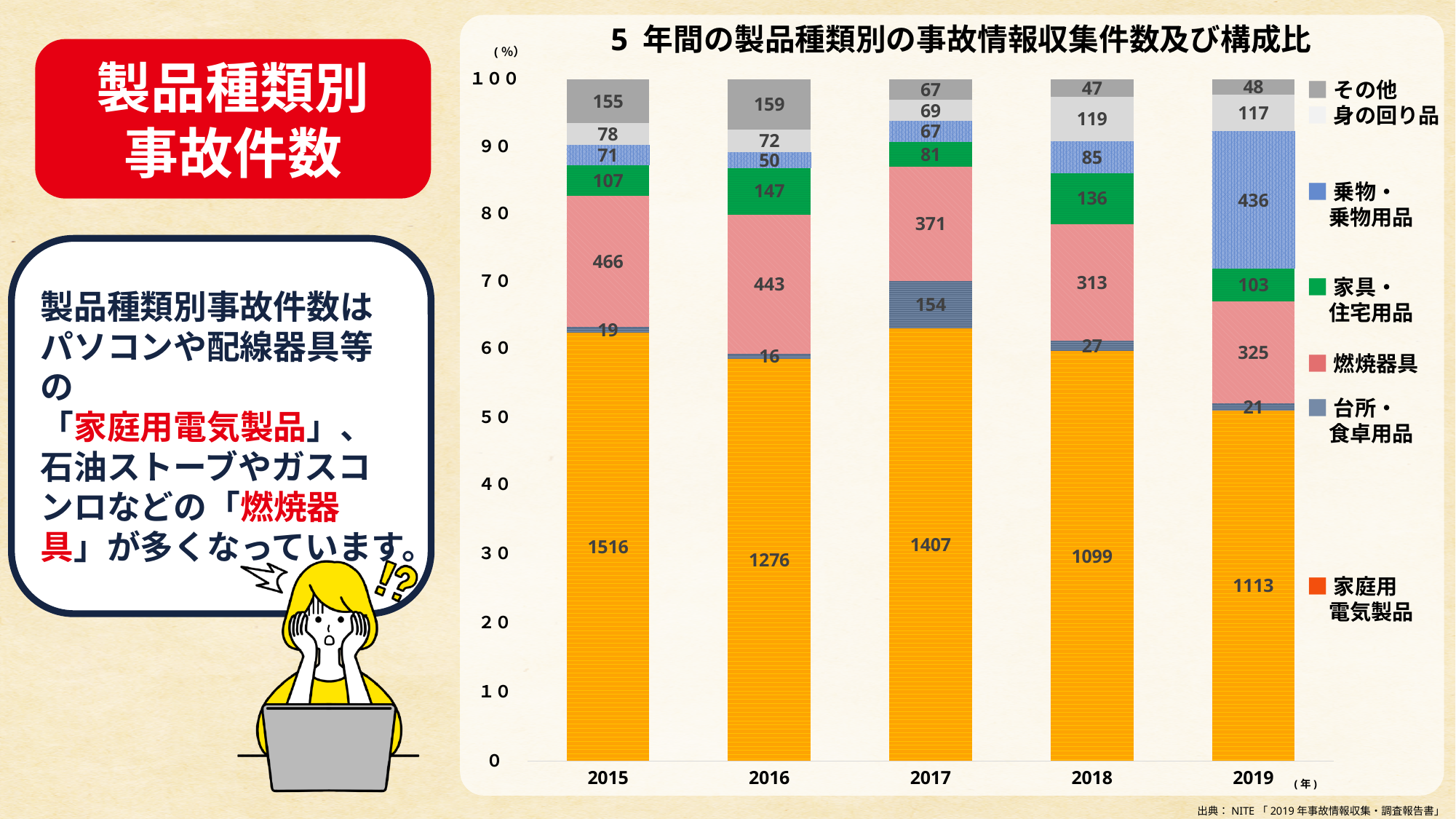
How many years are shown on the x axis? 5 How many series does the legend list? 7 What is the total of all labelled segments in the 2015 bar? 2412 What is the value for 乗物・乗物用品 in 2019? 436 In which year is the value for 家庭用電気製品 the lowest? 2018 What type of chart is shown on the slide? stacked bar chart What is the difference between the 家庭用電気製品 values in 2015 and 2016? 240 Is the share of 家庭用電気製品 in 2019 greater or less than 60%? less Which is larger, the 家具・住宅用品 value in 2016 or in 2018? 2016 What is the value for 燃焼器具 in 2017? 371 What is the value for 家庭用電気製品 in 2015? 1516 In which year is the value for 燃焼器具 the highest? 2015